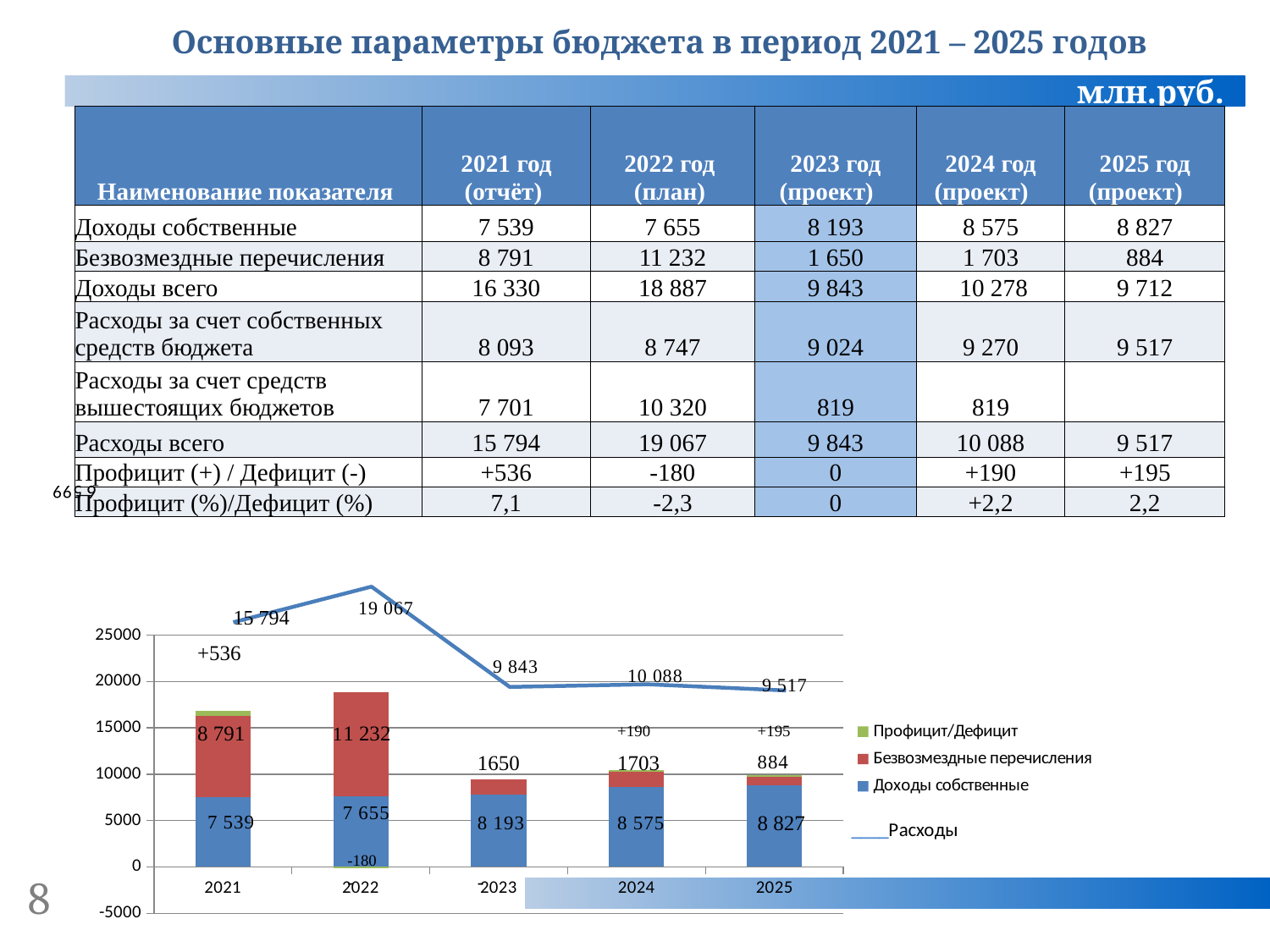
In the chart, does the value of Доходы собственные rise or fall from 2021 to 2025? rise In the chart, which year has the highest value of Безвозмездные перечисления? 2022 In the chart, which year has the highest value on the Расходы line? 2022 In the chart, what is the value of Доходы собственные for 2023? 8 193 In the chart, which year has the lowest value of Безвозмездные перечисления? 2025 In the chart, what is the value of Безвозмездные перечисления for 2022? 11 232 In the chart, what is the value of the Расходы line for 2024? 10 088 How many series does the chart legend list? 4 What kind of chart is shown at the bottom of the slide? Stacked bar chart with a line In the chart, is the Расходы line value for 2023 greater or less than 10000? less How many years are shown on the x axis of the chart? 5 In the chart, what is the difference between Доходы собственные in 2025 and in 2021? 1 288